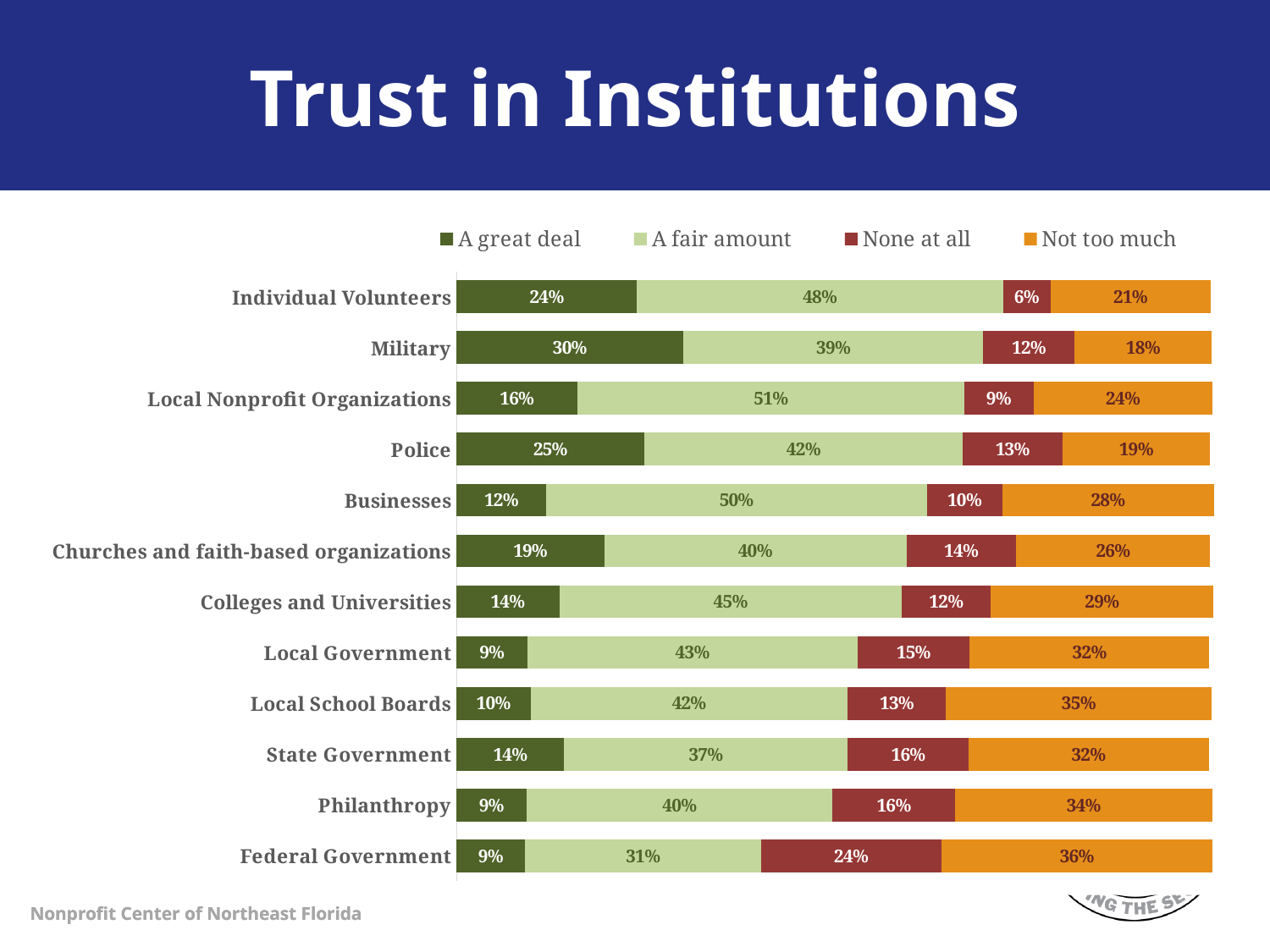
What percentage of respondents trust the Military 'A great deal'? 30% What is the 'Not too much' value for Federal Government? 36% Which institution has the lowest 'None at all' value? Individual Volunteers Which institution has the highest 'None at all' value? Federal Government Which has a larger 'A fair amount' value, Businesses or Police? Businesses What kind of chart is shown on the slide? Stacked bar chart What is the difference between the 'Not too much' values for Federal Government and Individual Volunteers? 15% Which institution has the highest 'A great deal' value? Military How many institutions are shown in the chart? 12 How many series does the legend list? 4 What is the title of the slide? Trust in Institutions What is the 'A fair amount' value for Local Nonprofit Organizations? 51%